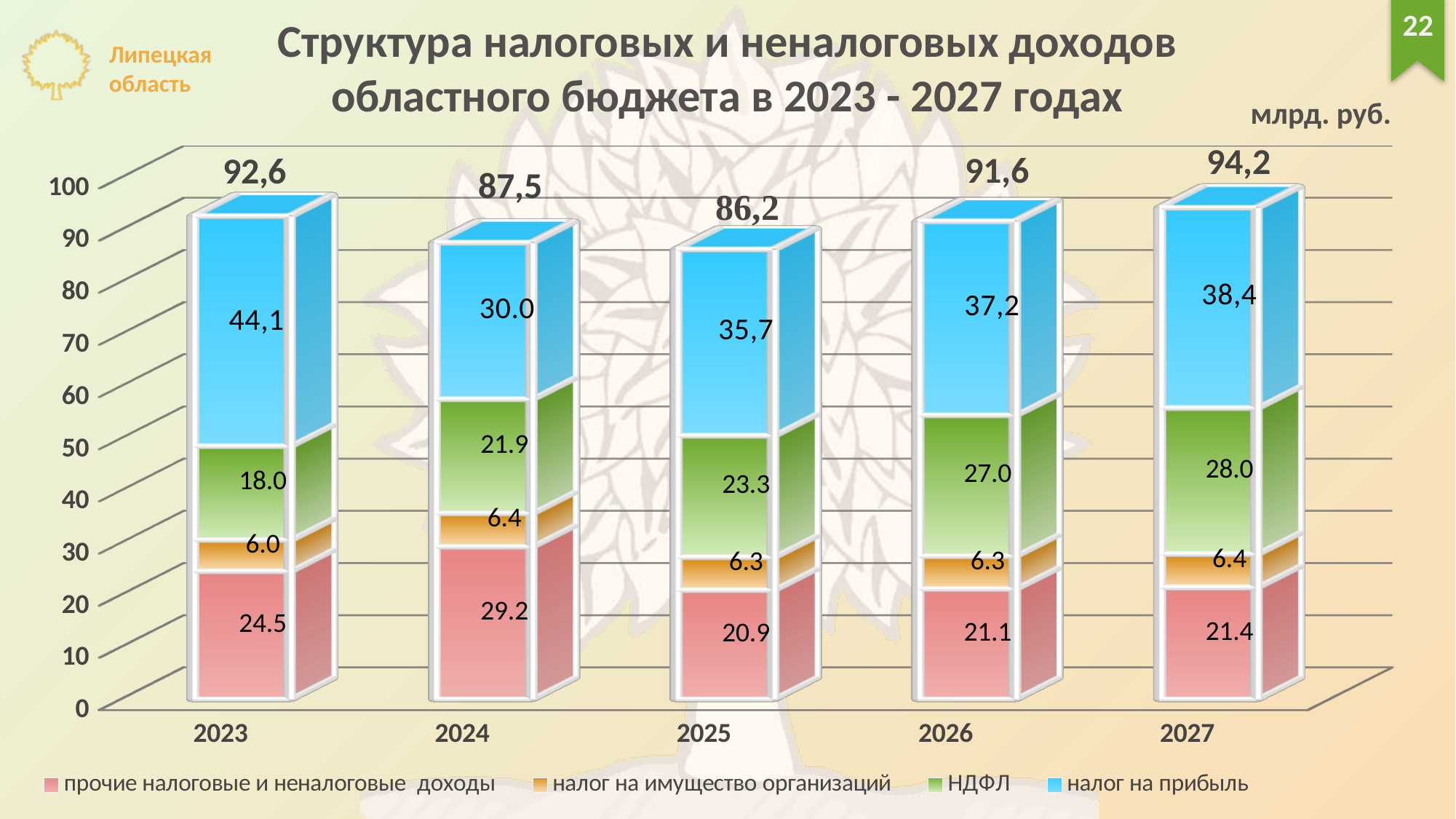
What kind of chart is shown on the slide? stacked bar chart What is the value of НДФЛ for 2026? 27.0 How many years are shown on the x axis? 5 Which year has the highest total? 2027 Which year has the larger НДФЛ value, 2024 or 2025? 2025 What is the value of налог на имущество организаций for 2025? 6.3 What is the value of прочие налоговые и неналоговые доходы for 2024? 29.2 What is the difference between the НДФЛ values for 2027 and 2023? 10.0 What is the value of налог на прибыль for 2023? 44,1 What is the total of the stacked bar for 2025? 86,2 Which year has the lowest total? 2025 How many series does the legend list? 4